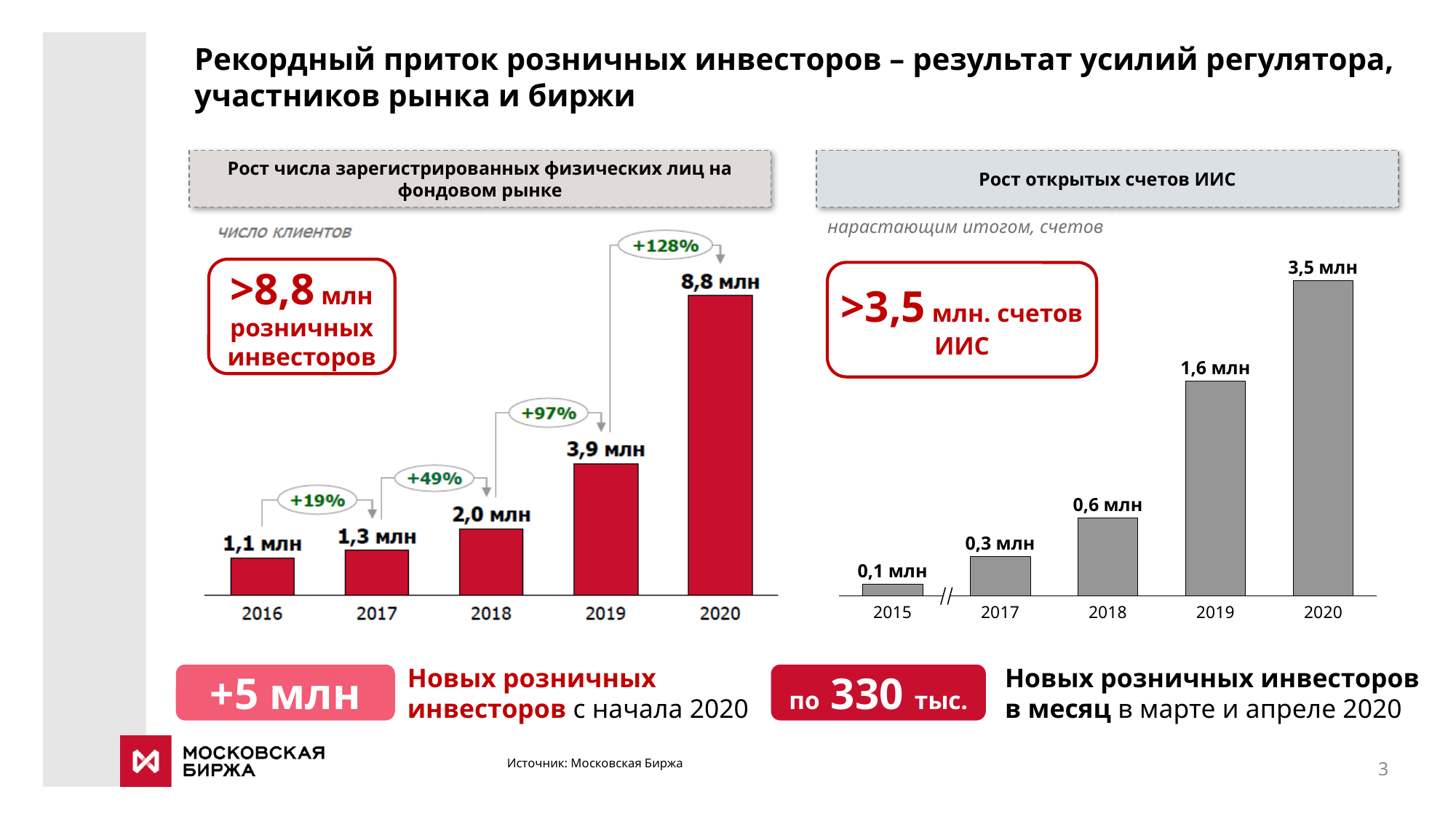
In the left chart (Рост числа зарегистрированных физических лиц на фондовом рынке), what is the difference between the 2020 and 2019 values? 4,9 млн In the left chart (Рост числа зарегистрированных физических лиц на фондовом рынке), how many years are plotted? 5 In the left chart (Рост числа зарегистрированных физических лиц на фондовом рынке), what is the value for 2018? 2,0 млн In the right chart (Рост открытых счетов ИИС), what is the value for 2019? 1,6 млн What type of chart is the right chart (Рост открытых счетов ИИС)? bar chart In the right chart (Рост открытых счетов ИИС), which is larger, the value for 2018 or the value for 2017? 2018 In the right chart (Рост открытых счетов ИИС), what is the value for 2015? 0,1 млн In the left chart (Рост числа зарегистрированных физических лиц на фондовом рынке), do the values rise or fall from 2016 to 2020? rise In the left chart (Рост числа зарегистрированных физических лиц на фондовом рынке), which year has the highest value? 2020 In the left chart (Рост числа зарегистрированных физических лиц на фондовом рынке), what percentage growth is shown between 2019 and 2020? +128% In the left chart (Рост числа зарегистрированных физических лиц на фондовом рынке), which year has the lowest value? 2016 In the right chart (Рост открытых счетов ИИС), what is the difference between the 2020 and 2019 values? 1,9 млн